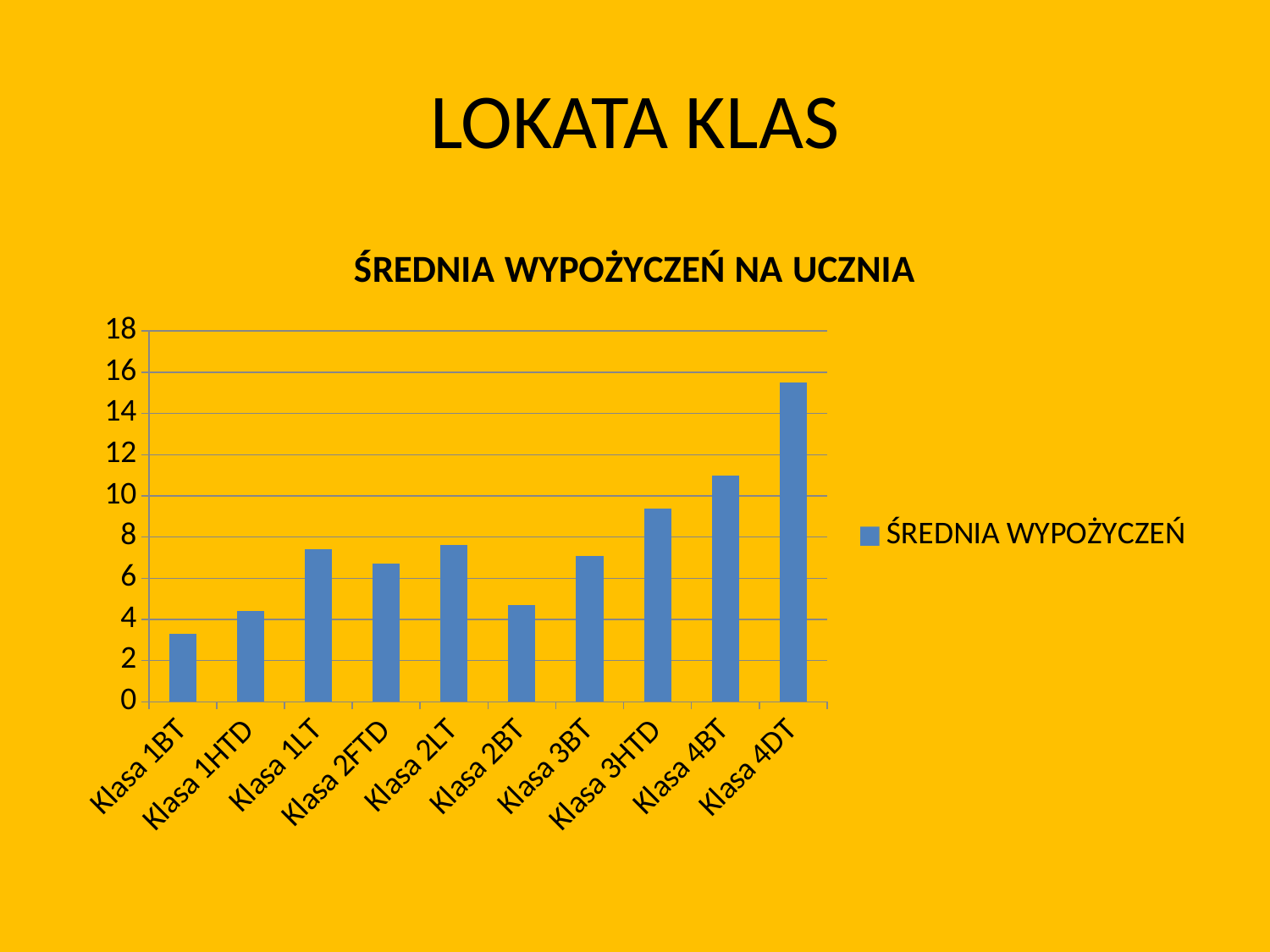
How many classes (categories) are shown on the x axis? 10 Which class has the highest average number of loans per student? Klasa 4DT Is the value for Klasa 3HTD greater or less than 8? greater Which has a larger value, Klasa 4BT or Klasa 3HTD? Klasa 4BT What kind of chart is shown on the slide? bar chart Is the value for Klasa 4DT greater or less than 14? greater Which has a larger value, Klasa 2LT or Klasa 2BT? Klasa 2LT What is the title of the chart? ŚREDNIA WYPOŻYCZEŃ NA UCZNIA Is the value for Klasa 2BT greater or less than 6? less How many series does the legend list? 1 Which class has the lowest average number of loans per student? Klasa 1BT